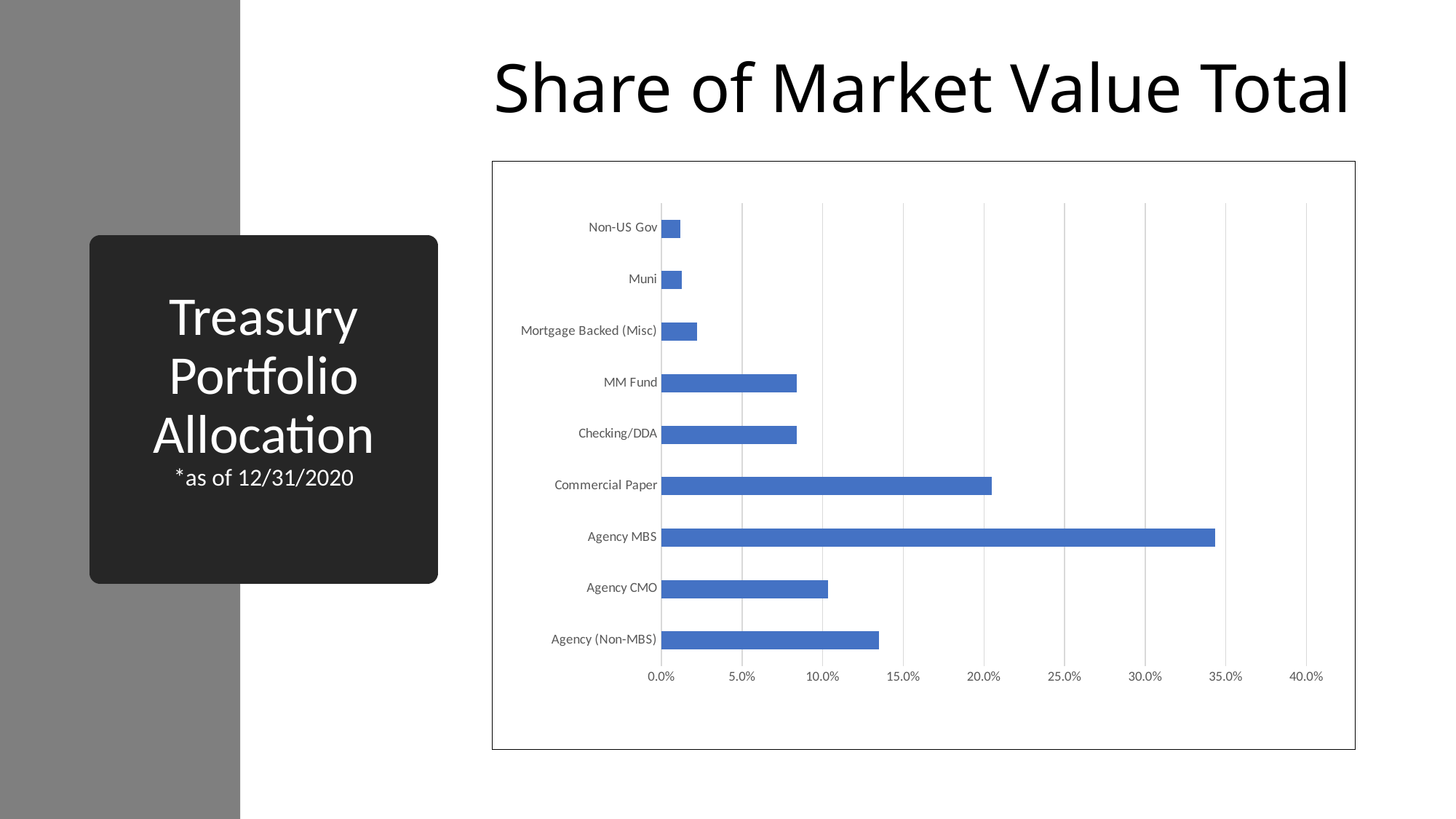
Is the value for Agency (Non-MBS) greater or less than 10.0%? greater What is the title of the chart? Share of Market Value Total Is the value for MM Fund greater or less than 10.0%? less Is the value for Mortgage Backed (Misc) greater or less than 5.0%? less How many categories are plotted in the chart? 9 Which category has the highest share of market value total? Agency MBS Which is larger, the value for Commercial Paper or the value for Agency CMO? Commercial Paper What kind of chart is shown on the slide? bar chart Which is larger, the value for Agency (Non-MBS) or the value for Agency CMO? Agency (Non-MBS)